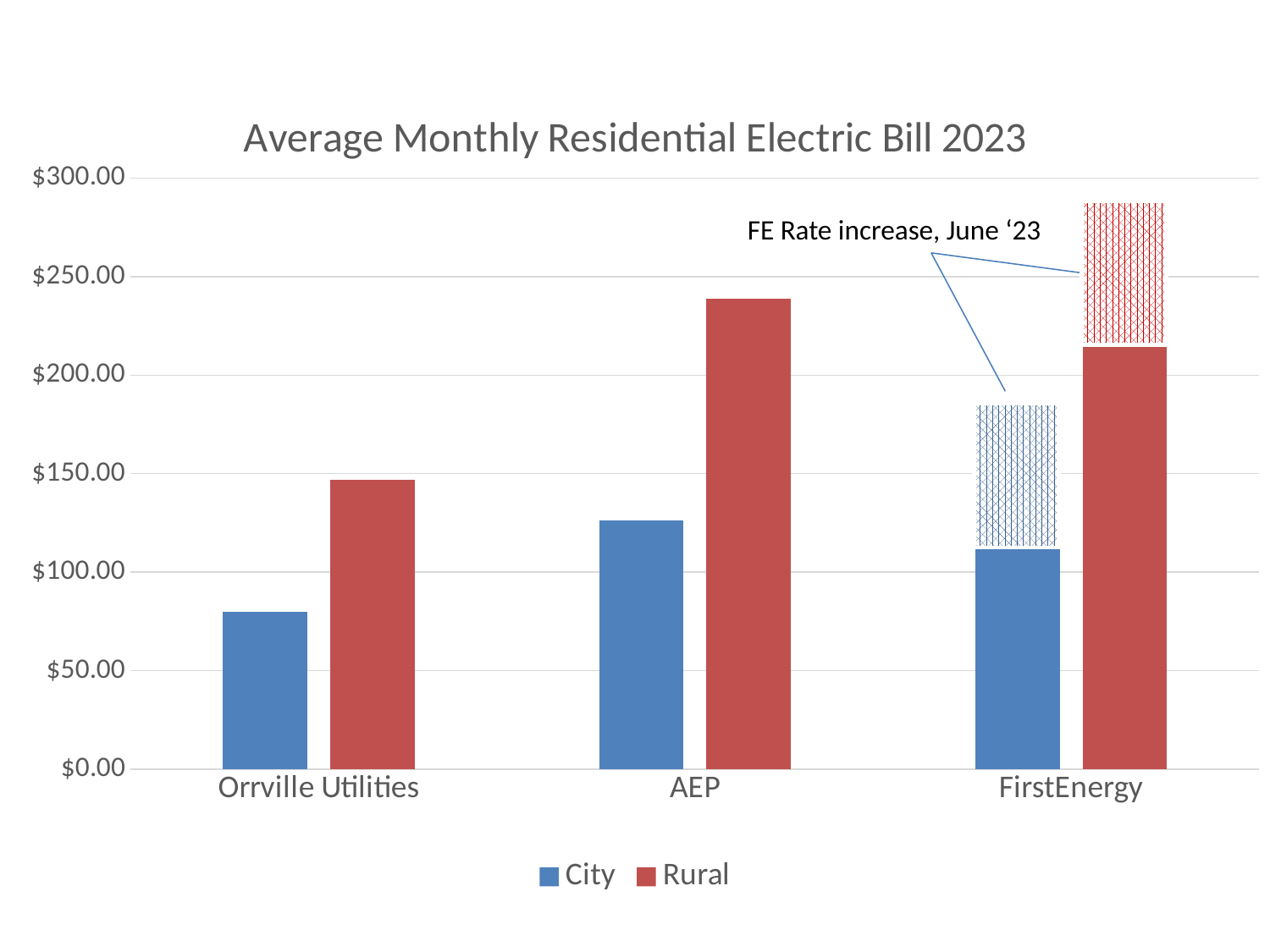
How many series does the legend list? 2 What kind of chart is shown on the slide? bar chart Which utility has the lowest City bar? Orrville Utilities Is the Rural value for Orrville Utilities greater or less than $100.00? greater Is the City value for Orrville Utilities greater or less than $100.00? less Is the Rural value for AEP greater or less than $200.00? greater What is the title of the chart? Average Monthly Residential Electric Bill 2023 Which utility has the highest Rural bar? AEP Which is larger, the Rural value for Orrville Utilities or the Rural value for AEP? AEP What does the annotation pointing to the hatched sections of the FirstEnergy bars say? FE Rate increase, June '23 How many utility categories are shown on the x axis? 3